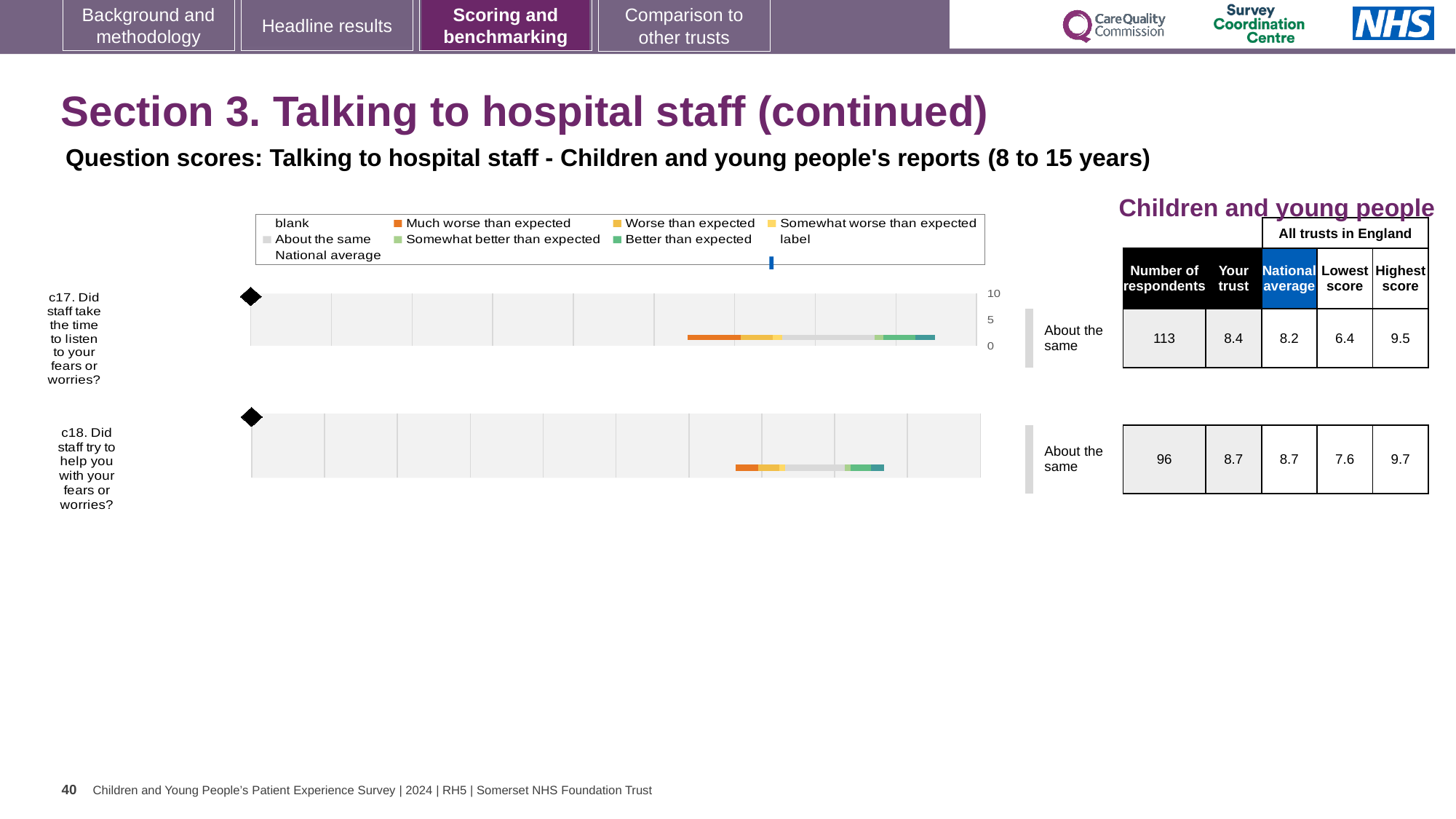
What benchmark category is shown for c18? About the same For c17, what is the difference between the 'Your trust' score and the national average? 0.2 How many entries does the chart legend list? 9 What kind of chart is used to show the question scores for c17 and c18? bar chart For c17, what is the national average score? 8.2 For c18, what is the difference between the highest score and the lowest score among all trusts in England? 2.1 For c18, what is the highest score among all trusts in England? 9.7 Which question has more respondents, c17 or c18? c17 For c17 (Did staff take the time to listen to your fears or worries?), what is the 'Your trust' score? 8.4 How many questions (c17 and c18) are plotted on the slide? 2 For c17, which is larger: the 'Your trust' score or the national average? Your trust For c18 (Did staff try to help you with your fears or worries?), what is the number of respondents? 96